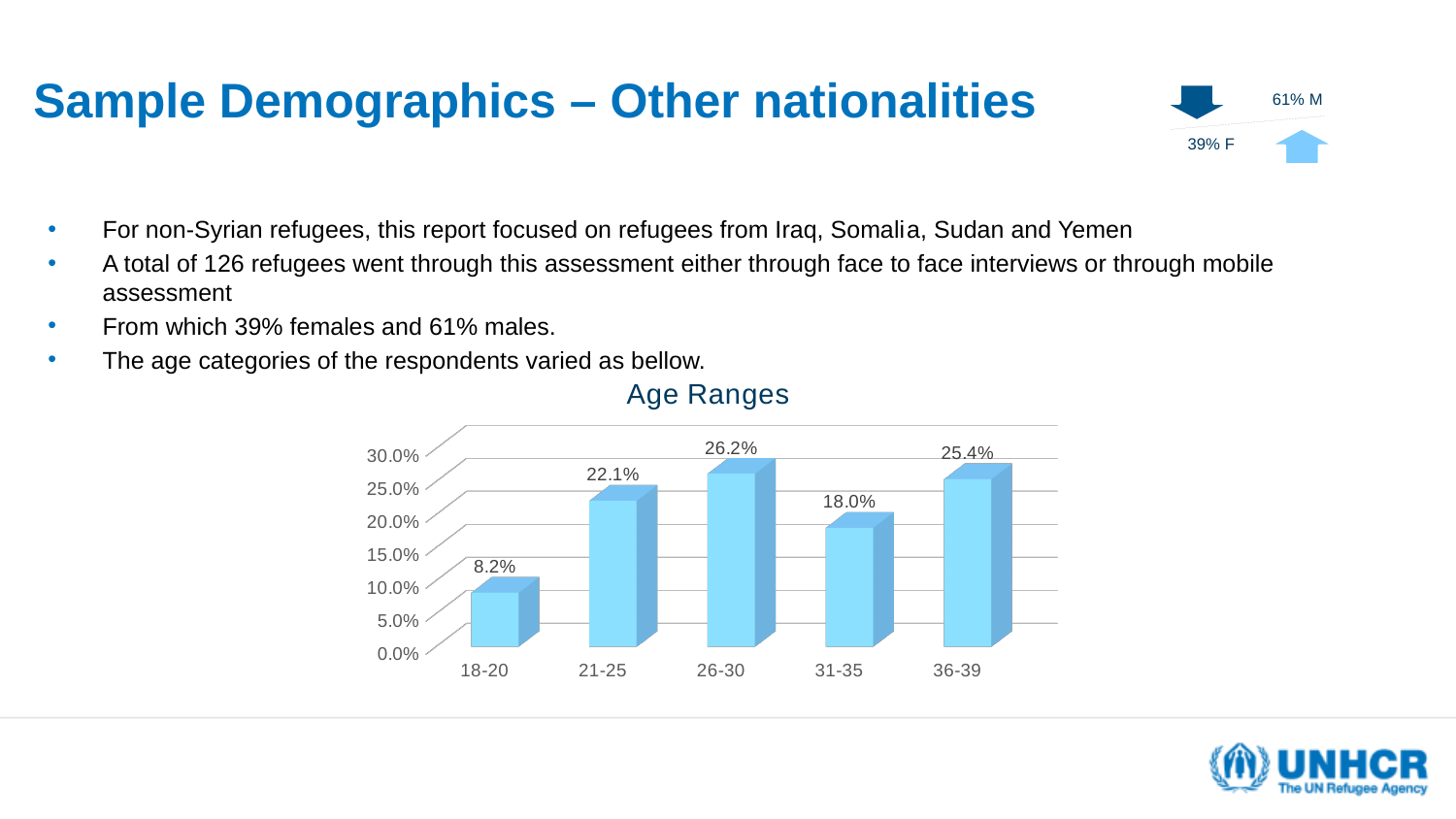
What is the difference between the values for 36-39 and 31-35 in the Age Ranges chart? 7.4% What is the title of the chart on the slide? Age Ranges Which is larger in the Age Ranges chart, the value for 21-25 or the value for 31-35? 21-25 Is the value for 36-39 in the Age Ranges chart greater or less than 20.0%? greater What is the difference between the values for 26-30 and 18-20 in the Age Ranges chart? 18.0% Which age range has the highest value in the Age Ranges chart? 26-30 Which age range has the lowest value in the Age Ranges chart? 18-20 What is the value for the 31-35 age range in the Age Ranges chart? 18.0% What kind of chart is the Age Ranges chart? bar chart How many age ranges are shown in the Age Ranges chart? 5 What is the value for the 21-25 age range in the Age Ranges chart? 22.1% What is the value for the 18-20 age range in the Age Ranges chart? 8.2%